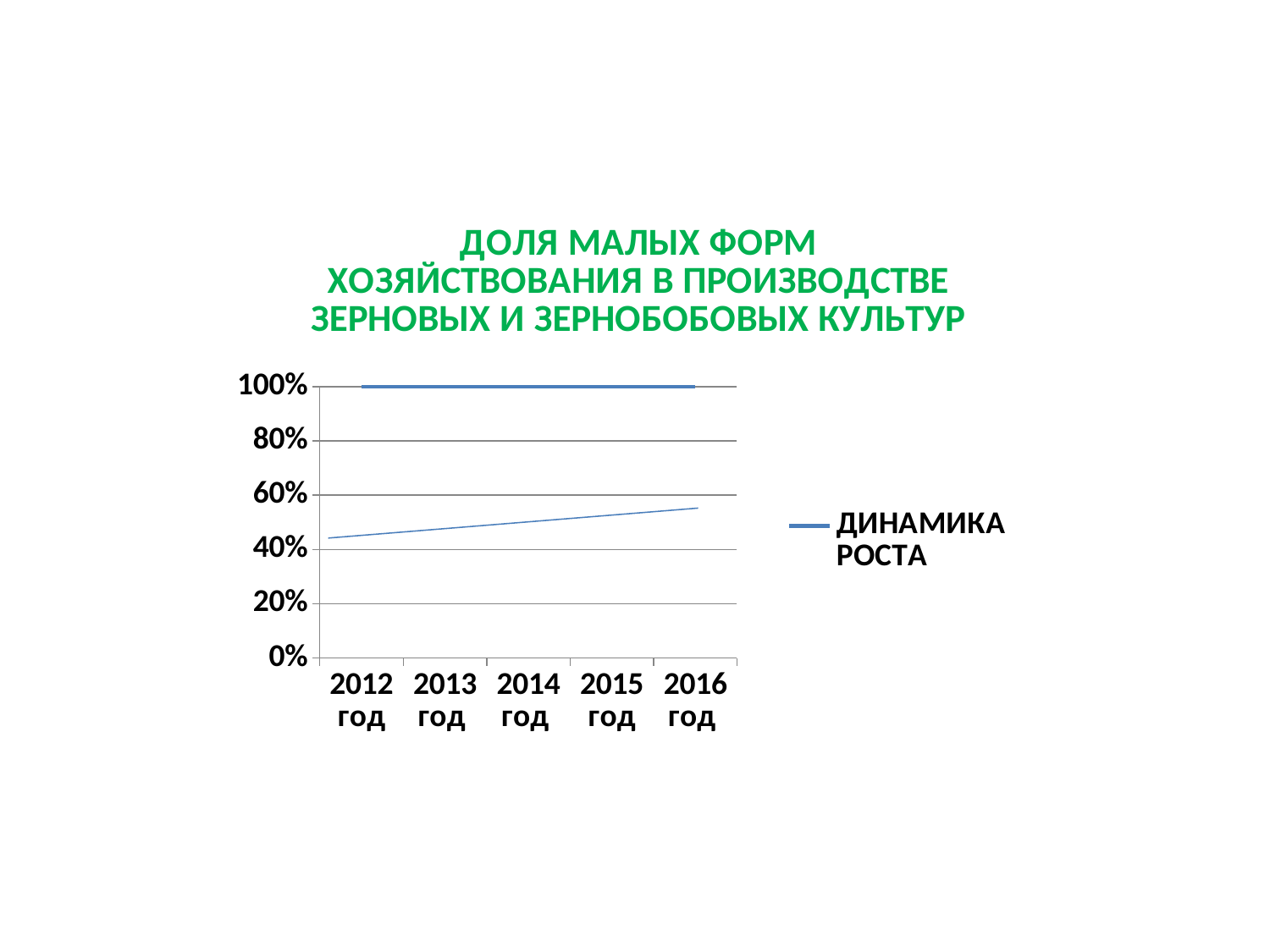
Is the value of the rising line for 2012 год greater or less than 40%? greater On the rising line, which is larger: the value for 2012 год or the value for 2016 год? 2016 год Does the rising line in the chart go up or down from 2012 год to 2016 год? up Is the value of the rising line for 2016 год greater or less than 60%? less Is the value of the rising line for 2012 год greater or less than 60%? less How many series does the chart's legend list? 1 On the rising line, which year has the lowest value? 2012 год How many years are shown along the x axis of the chart? 5 What kind of chart is shown on the slide? line chart What is the name of the series listed in the chart's legend? ДИНАМИКА РОСТА What is the title of the chart? ДОЛЯ МАЛЫХ ФОРМ ХОЗЯЙСТВОВАНИЯ В ПРОИЗВОДСТВЕ ЗЕРНОВЫХ И ЗЕРНОБОБОВЫХ КУЛЬТУР